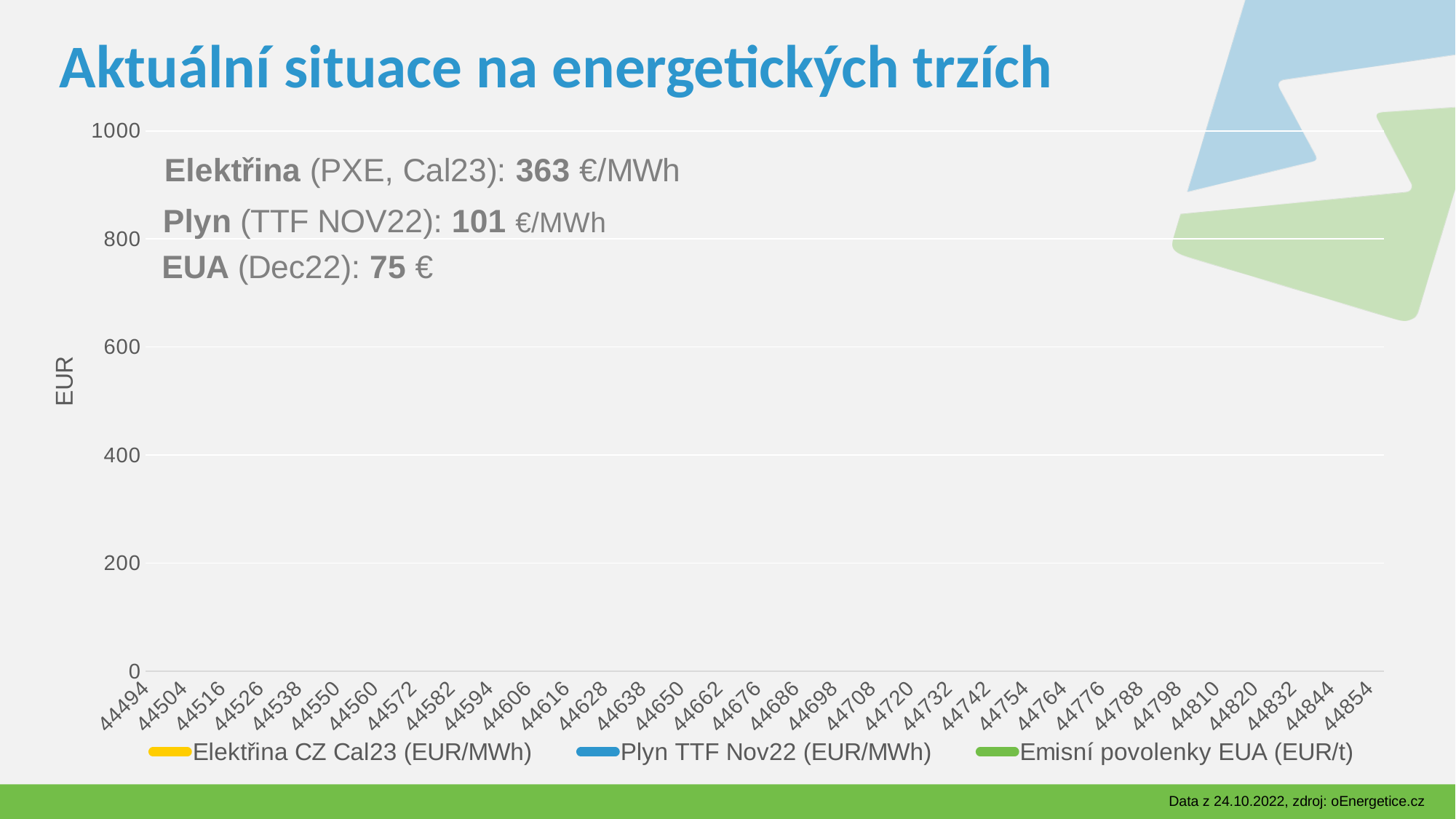
How many series does the chart legend list? 3 What is the first tick label on the horizontal axis of the chart? 44494 How many tick labels are shown on the horizontal axis of the chart? 33 What is the last tick label on the horizontal axis of the chart? 44854 What is the highest value shown on the vertical axis of the chart? 1000 What kind of chart is shown on the slide? line chart What is the label on the vertical axis of the chart? EUR Which series in the legend is shown in yellow? Elektřina CZ Cal23 (EUR/MWh)